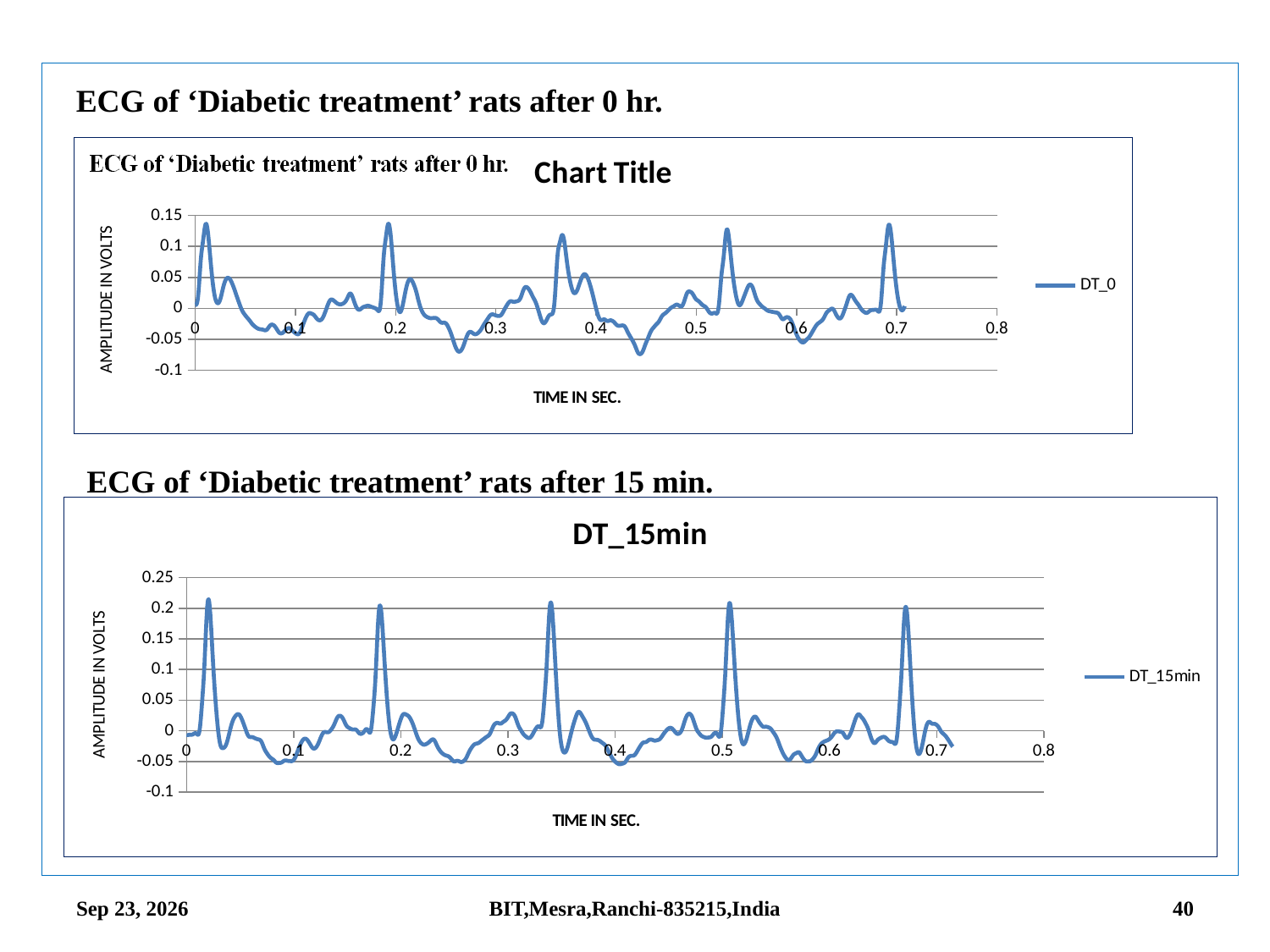
In the top chart titled 'Chart Title', how many series does the legend list? 1 In the top chart titled 'Chart Title', is the value of the DT_0 line at time 0.1 greater or less than 0? less In the bottom chart titled 'DT_15min', how many large peaks does the DT_15min line show? 5 In the bottom chart titled 'DT_15min', is the highest peak of the DT_15min line greater or less than 0.25? less In the bottom chart titled 'DT_15min', what is the label of the vertical axis? AMPLITUDE IN VOLTS In the bottom chart titled 'DT_15min', is the highest peak of the DT_15min line greater or less than 0.15? greater What kind of chart is the top chart titled 'Chart Title'? line chart In the top chart titled 'Chart Title', what is the name of the series shown in the legend? DT_0 What kind of chart is the bottom chart titled 'DT_15min'? line chart In the bottom chart titled 'DT_15min', how many series does the legend list? 1 Which chart shows the higher peak amplitude, the top chart titled 'Chart Title' or the bottom chart titled 'DT_15min'? the bottom chart (DT_15min)